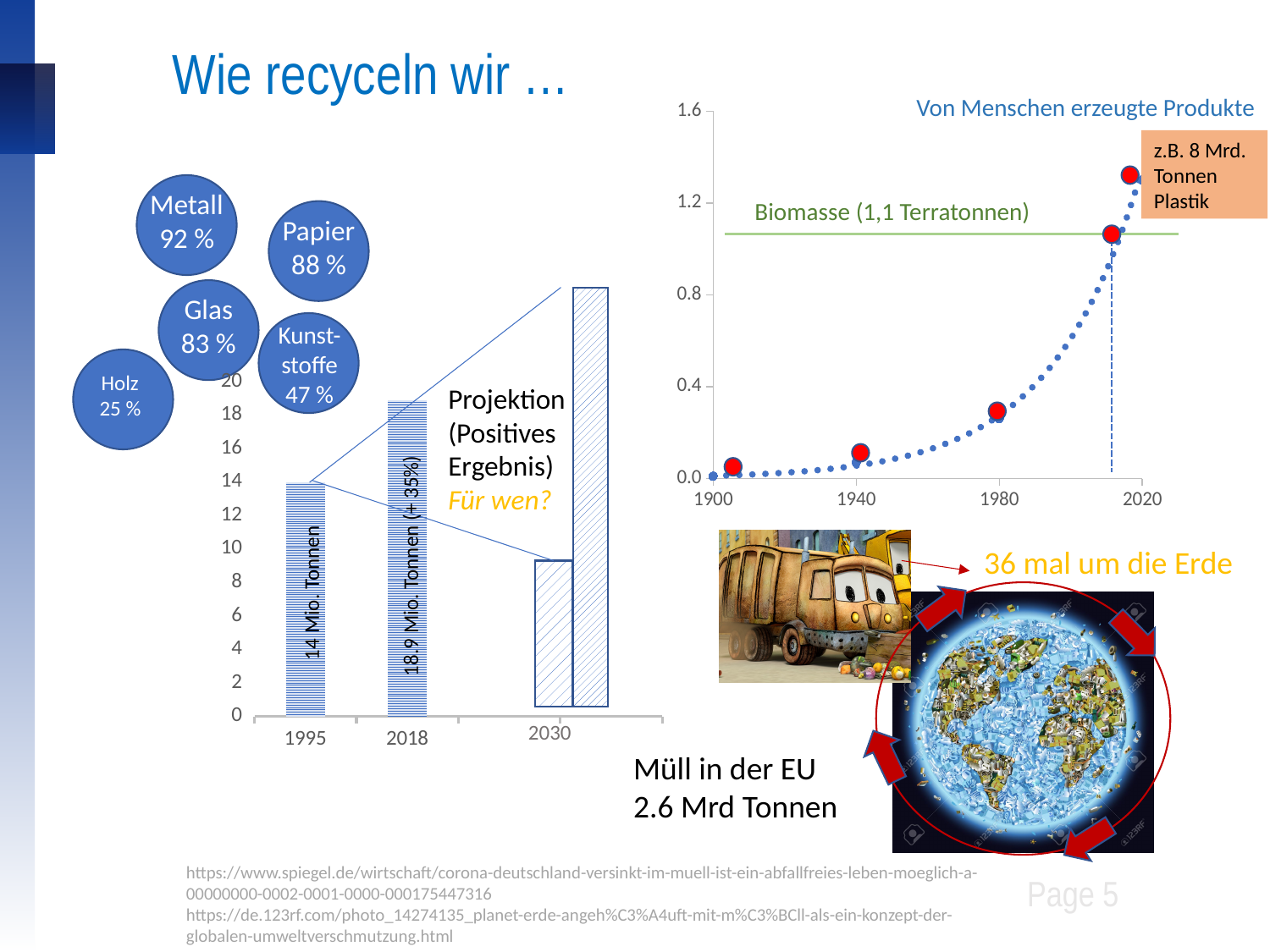
In the bar chart on the left, is the taller projection bar for 2030 greater or less than 20? greater In the bar chart on the left, what is the difference between the labelled values for 2018 and 1995? 4.9 Mio. Tonnen In the chart on the right, is the value of the red point at 1980 greater or less than 0.4? less In the chart on the right, what value is given for the horizontal Biomasse line? 1,1 Terratonnen In the bar chart on the left, is the shorter projection bar for 2030 greater or less than 12? less What is the title of the chart on the right of the slide? Von Menschen erzeugte Produkte In the bar chart on the left, which year has the larger labelled value, 1995 or 2018? 2018 In the bar chart on the left, what value is labelled on the bar for 2018? 18.9 Mio. Tonnen In the bar chart on the left, how many years are shown on the x axis? 3 What kind of chart is the chart on the left of the slide? bar chart In the chart on the right, do the plotted values rise or fall from 1900 to 2020? rise In the bar chart on the left, what value is labelled on the bar for 1995? 14 Mio. Tonnen